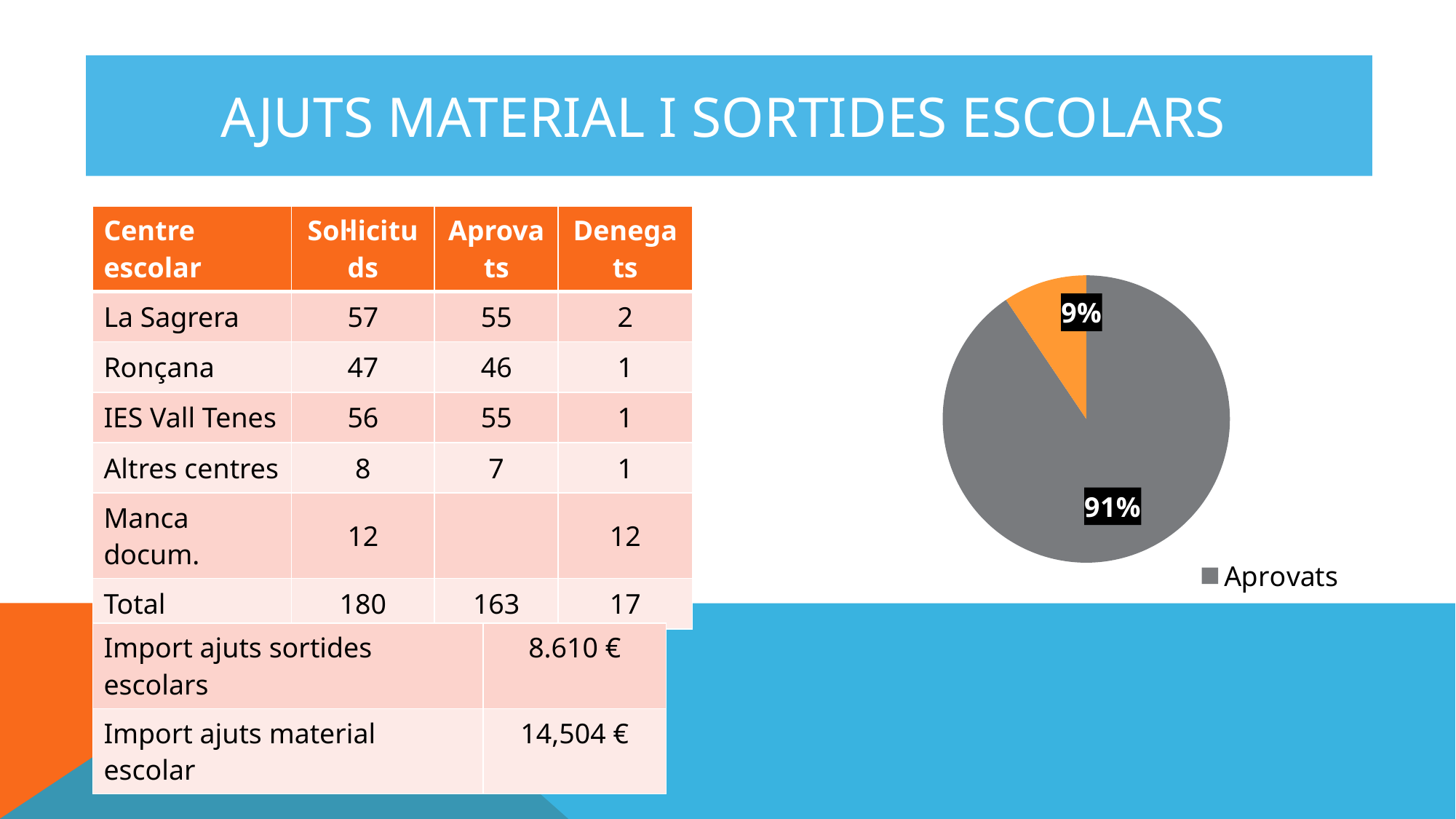
Which slice of the pie chart is the largest? Aprovats How many entries are listed in the pie chart's legend? 1 What is the only entry shown in the pie chart's legend? Aprovats How many slices does the pie chart have? 2 What colour is the Aprovats slice in the pie chart? grey Is the Aprovats slice of the pie chart larger or smaller than the other slice? larger What share of the pie chart does the Aprovats slice represent? 91% What is the difference in percentage points between the two slices of the pie chart? 82 What percentage is shown on the smaller slice of the pie chart? 9% What kind of chart is shown on the slide? pie chart